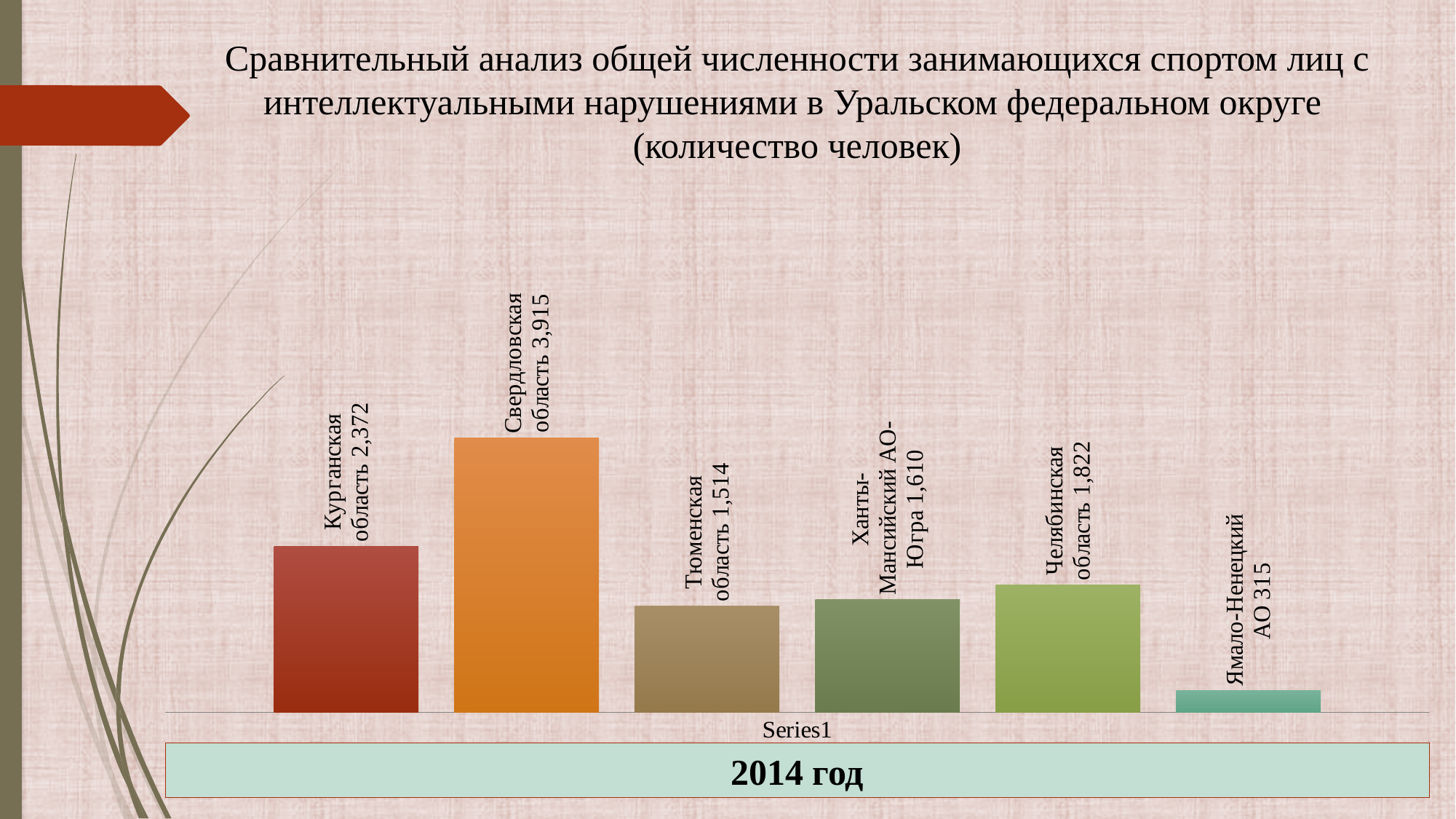
Which region has the highest value? Свердловская область What kind of chart is shown on the slide? Bar chart What is the value for Ханты-Мансийский АО-Югра? 1,610 What is the difference between the values for Челябинская область and Тюменская область? 308 Which region has the lowest value? Ямало-Ненецкий АО How many regions (bars) are shown in the chart? 6 What is the difference between the values for Свердловская область and Курганская область? 1,543 What year is indicated in the box below the chart? 2014 год Which is larger, the value for Челябинская область or the value for Ханты-Мансийский АО-Югра? Челябинская область What is the value for Свердловская область? 3,915 What is the value for Курганская область? 2,372 What is the value for Ямало-Ненецкий АО? 315